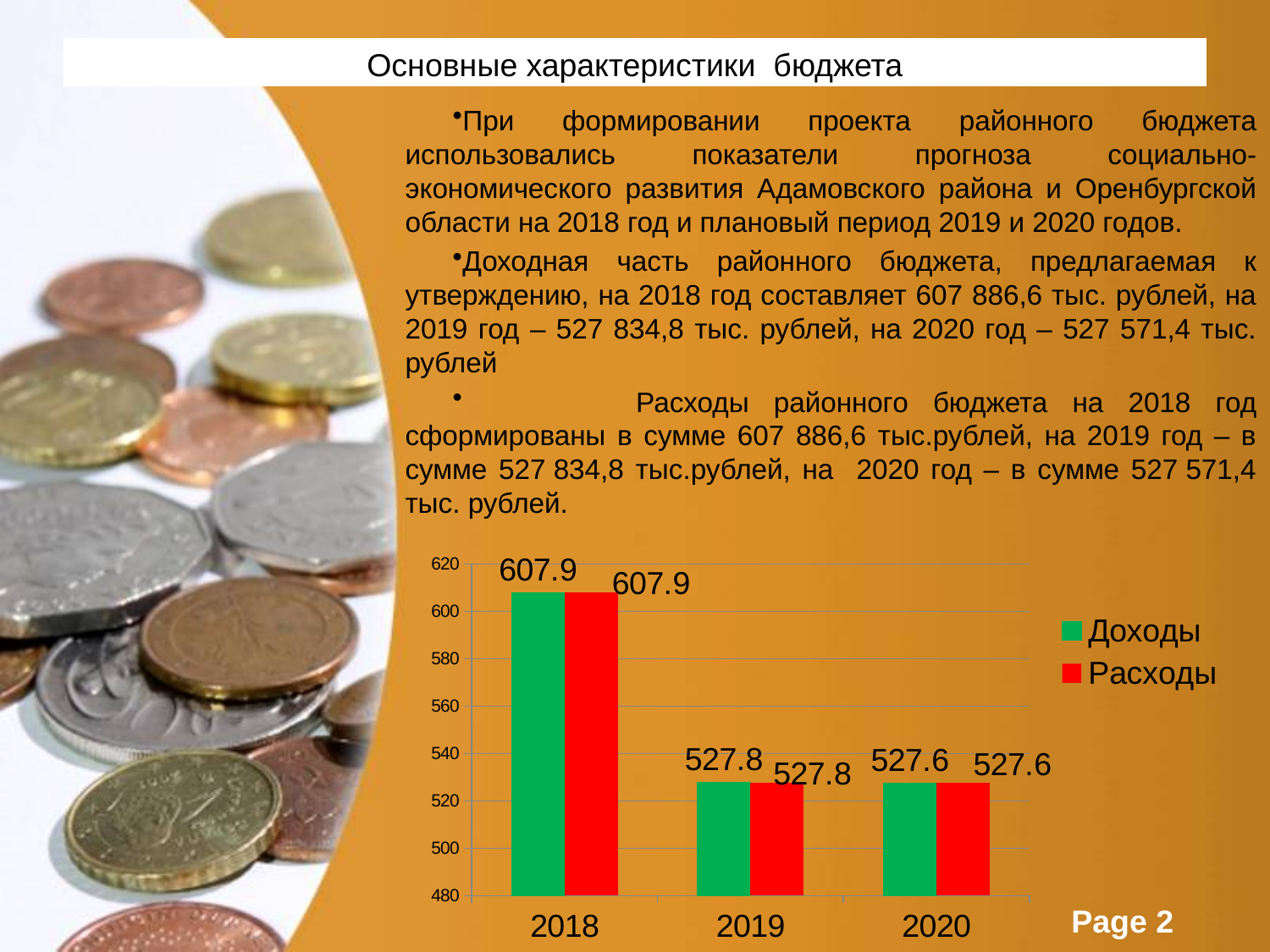
Do the Доходы values rise or fall from 2018 to 2020? fall Is the value of Доходы for 2019 greater or less than 540? less What is the value of Доходы for 2018? 607.9 Which is larger: Расходы for 2018 or Расходы for 2020? Расходы for 2018 What kind of chart is shown on the slide? bar chart How many series does the chart legend list? 2 Which year has the highest value for Расходы? 2018 What is the value of Доходы for 2020? 527.6 What is the value of Расходы for 2019? 527.8 What is the difference between the Доходы value for 2018 and the Доходы value for 2019? 80.1 Which year has the lowest value for Доходы? 2020 How many years are shown on the x axis of the chart? 3